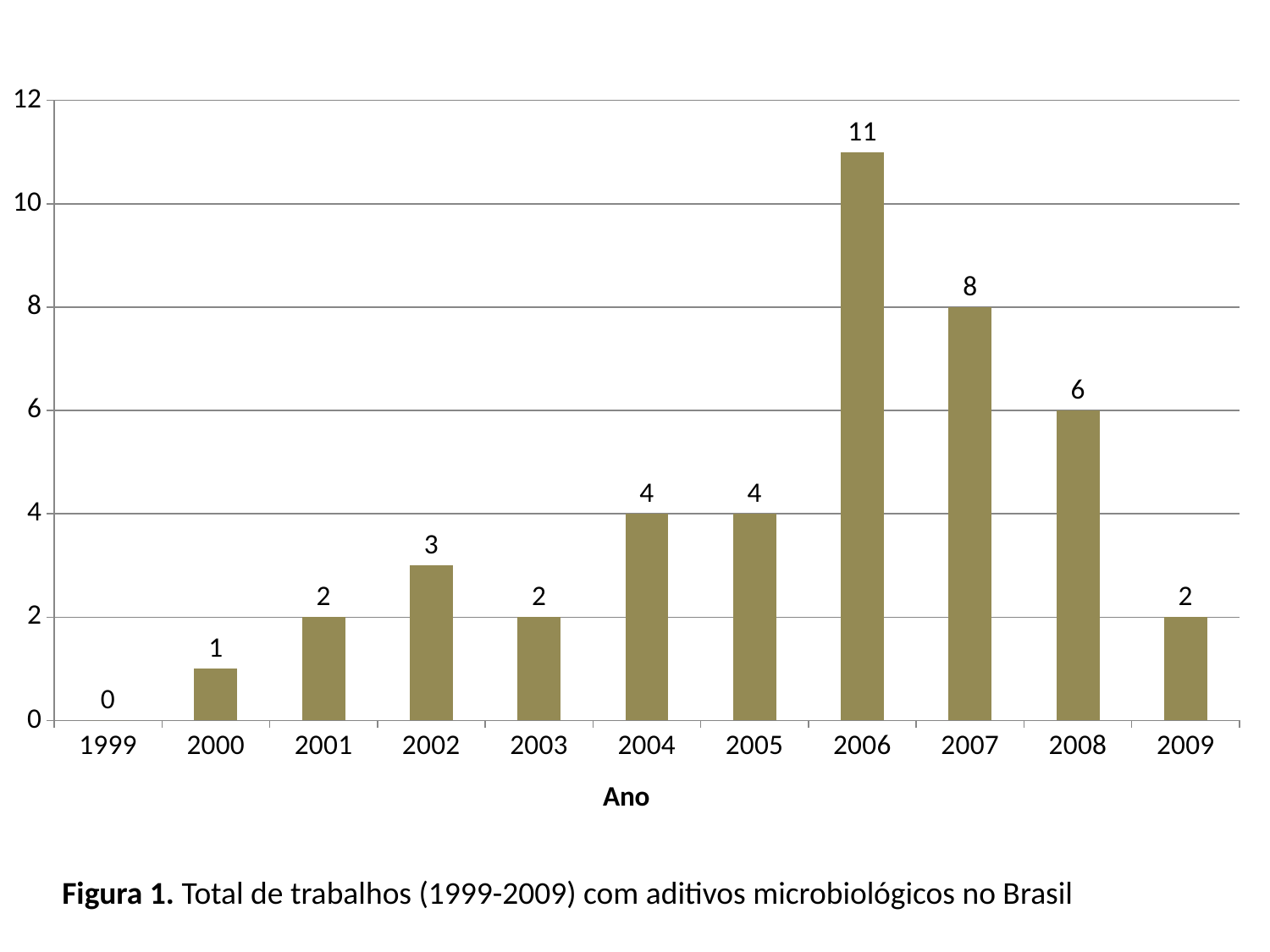
How many years are shown on the x axis? 11 Is the value for 2006 greater or less than 10? greater Which is larger, the value for 2007 or the value for 2008? 2007 What is the difference between the values for 2006 and 2007? 3 What is the label of the x axis? Ano What is the value for 1999? 0 Which year has the lowest value? 1999 What is the value for 2002? 3 What is the difference between the values for 2008 and 2009? 4 What is the value for 2006? 11 What kind of chart is this? bar chart Which year has the highest value? 2006